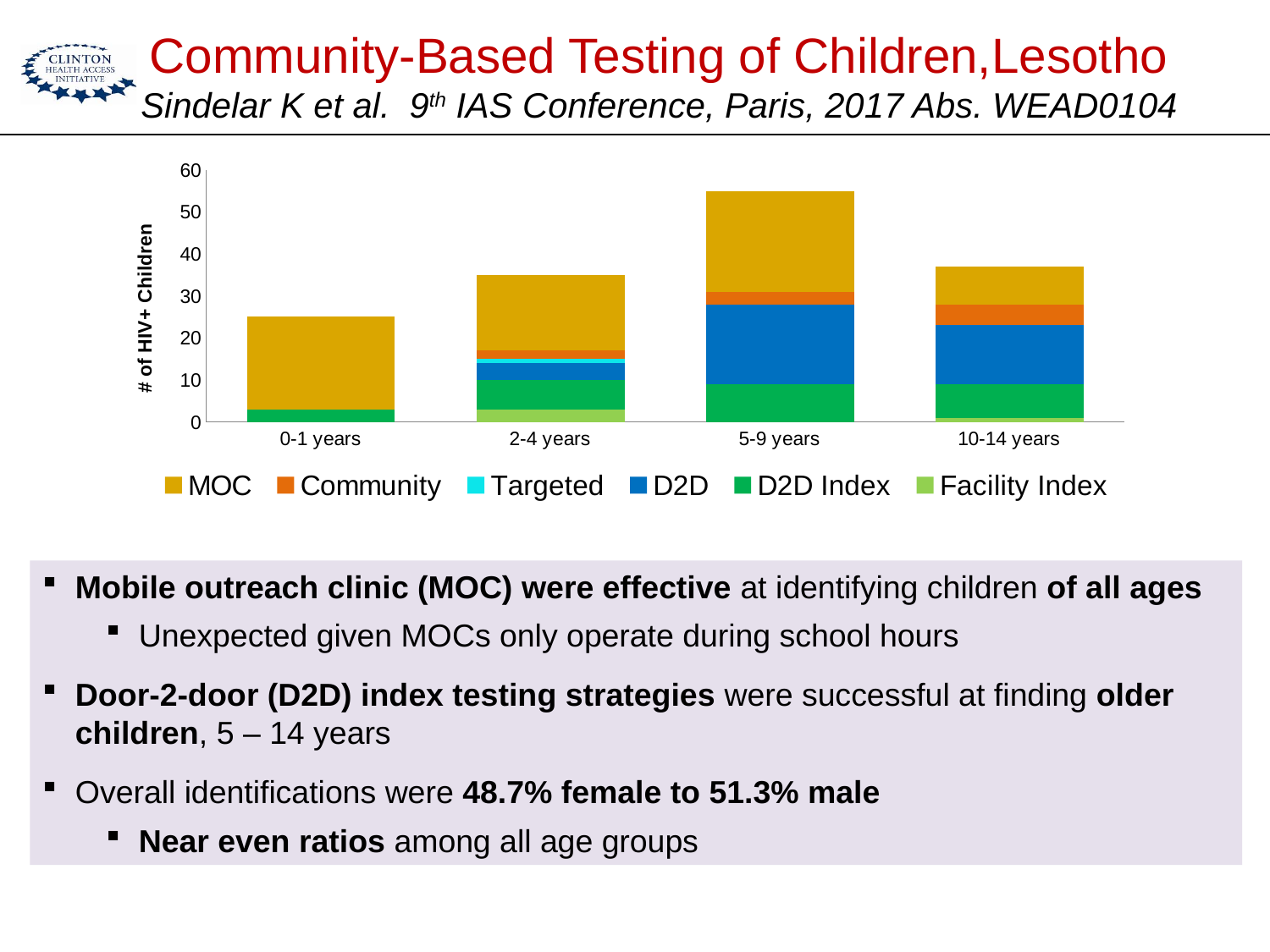
Which series is listed first in the chart's legend? MOC Is the total bar height for 5-9 years greater or less than 50? greater What is the label on the chart's y axis? # of HIV+ Children What kind of chart is shown on the slide? Stacked bar chart Which age group has the tallest stacked bar (most HIV+ children identified)? 5-9 years Which age group has the shortest stacked bar? 0-1 years How many series does the chart's legend list? 6 Is the total bar height for 2-4 years greater or less than 30? greater Which has the taller stacked bar, 5-9 years or 10-14 years? 5-9 years How many age groups are shown on the x axis of the chart? 4 Is the total bar height for 0-1 years greater or less than 30? less